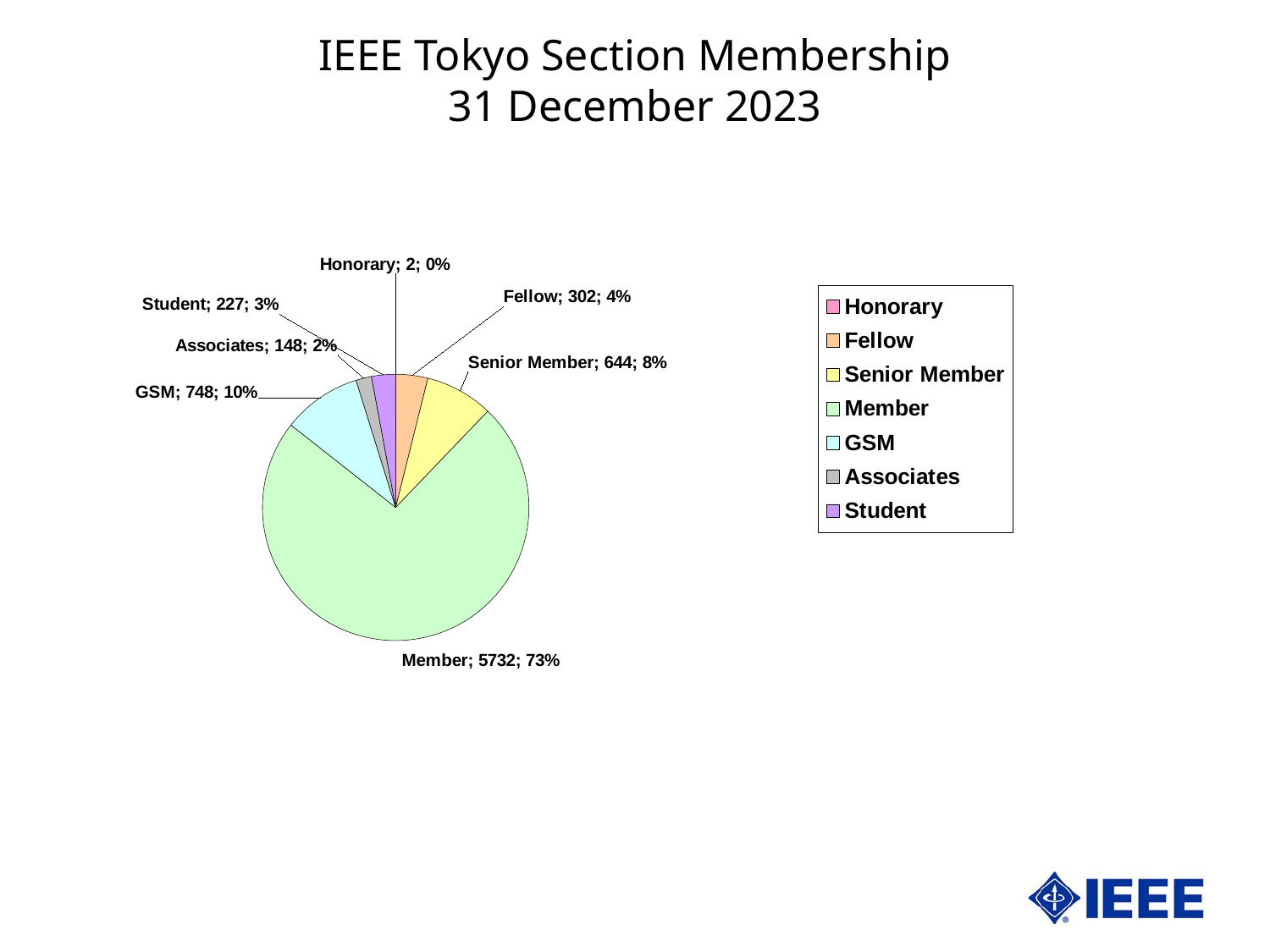
How many members are in the Member category? 5732 What is the value for Senior Member? 644 What share of the pie does GSM represent? 10% Which is larger, Senior Member or GSM? GSM How many categories does the legend list? 7 What kind of chart is shown on the slide? pie chart What is the difference between the Fellow and Student values? 75 Which category has the largest slice? Member What share of the pie does Member represent? 73% Which category has the smallest slice? Honorary What is the value for GSM? 748 What is the value for Honorary? 2